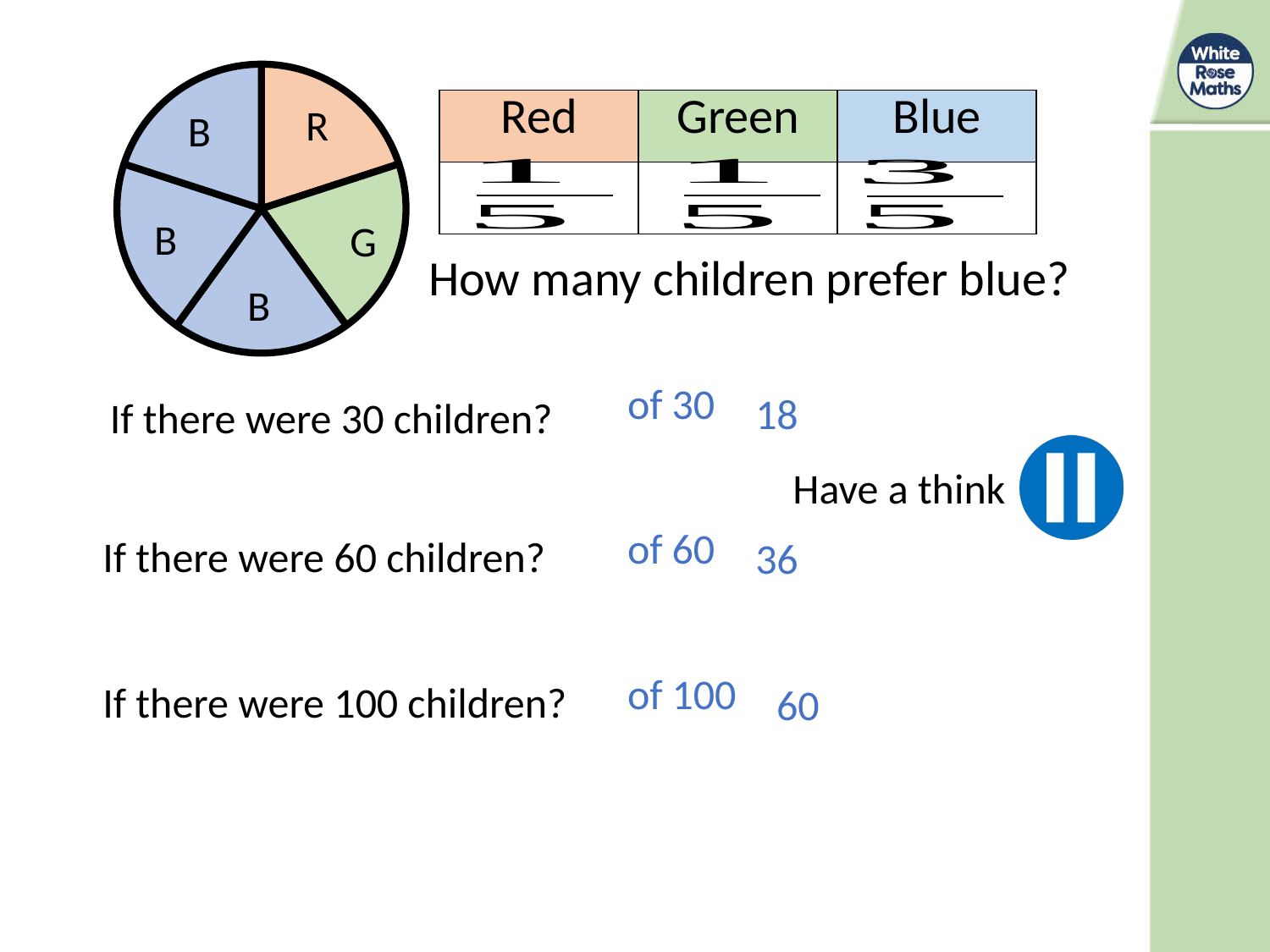
How many colour categories does the table above the pie chart list? 3 According to the table, what fraction of the pie chart is Blue? 3/5 How many slices does the pie chart have? 5 Which colour has the largest share of the pie chart? Blue According to the table, what fraction of the pie chart is Green? 1/5 What colour are the slices labelled B in the pie chart? blue What colour is the slice labelled G in the pie chart? green According to the table, what fraction of the pie chart is Red? 1/5 Which is larger in the pie chart, the share for Blue or the share for Green? Blue How many slices of the pie chart are labelled B? 3 What kind of chart is shown on the slide? pie chart